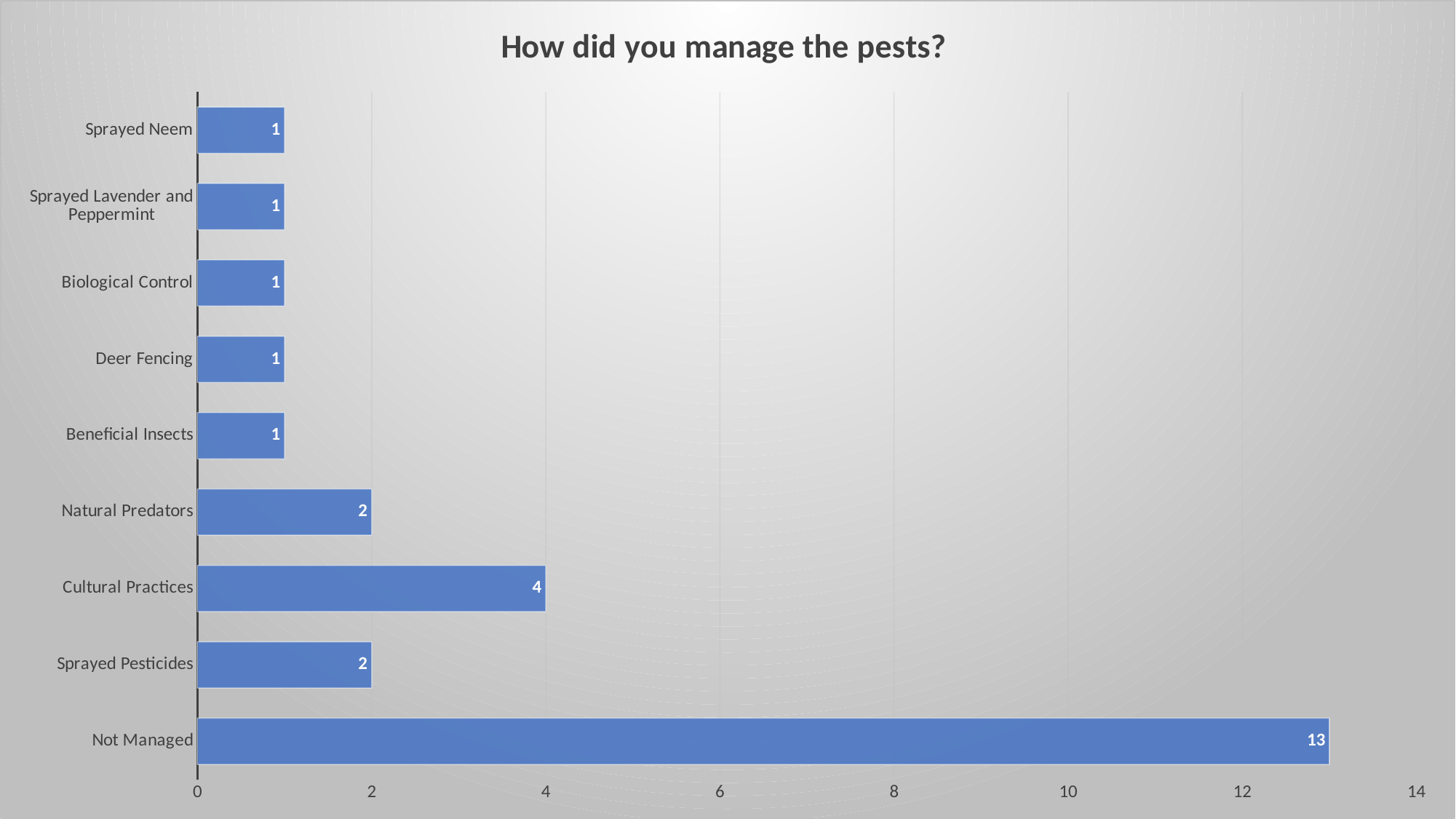
Is the value for Not Managed greater or less than 12? greater What is the title of the chart? How did you manage the pests? Which category has the highest value? Not Managed Which is larger, the value for Cultural Practices or the value for Natural Predators? Cultural Practices What is the value for Natural Predators? 2 How many categories are shown in the chart? 9 What is the value for Cultural Practices? 4 What is the value for Not Managed? 13 What is the difference between the values for Not Managed and Cultural Practices? 9 What kind of chart is shown on the slide? Bar chart What is the value for Deer Fencing? 1 What is the difference between the values for Cultural Practices and Sprayed Pesticides? 2